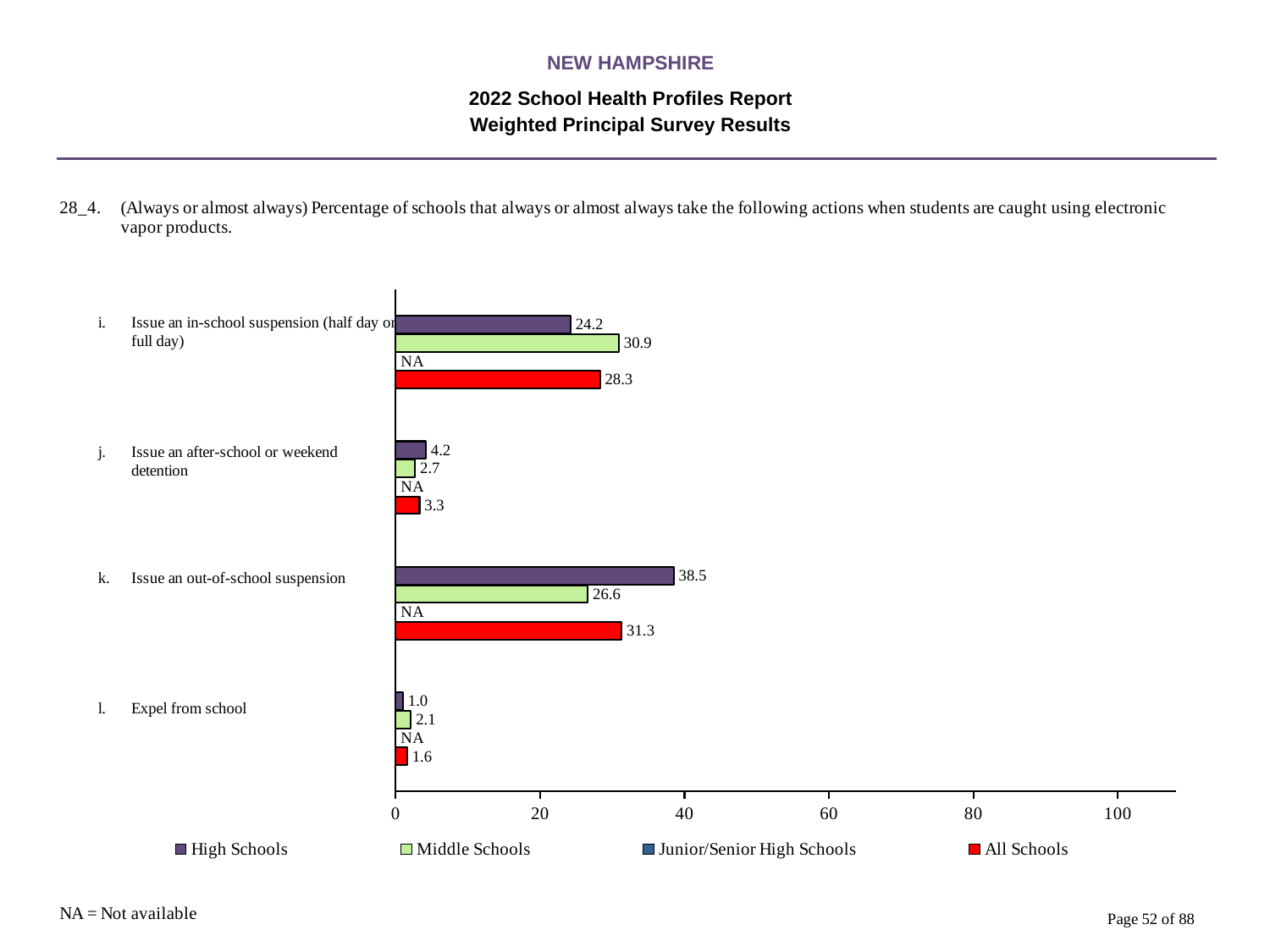
How many actions (categories) are shown on the chart? 4 What is the value for Middle Schools for 'Issue an in-school suspension (half day or full day)'? 30.9 Which action has the lowest value for High Schools? Expel from school Is the All Schools value for 'Issue an out-of-school suspension' greater or less than 40? less What kind of chart is shown on the slide? bar chart What is the value for High Schools for 'Issue an out-of-school suspension'? 38.5 What is the value for Junior/Senior High Schools for 'Expel from school'? NA What is the difference between the High Schools and Middle Schools values for 'Issue an out-of-school suspension'? 11.9 Which is larger for 'Issue an in-school suspension (half day or full day)': the High Schools value or the Middle Schools value? Middle Schools What is the value for All Schools for 'Issue an after-school or weekend detention'? 3.3 Which action has the highest value for All Schools? Issue an out-of-school suspension How many series does the legend list? 4